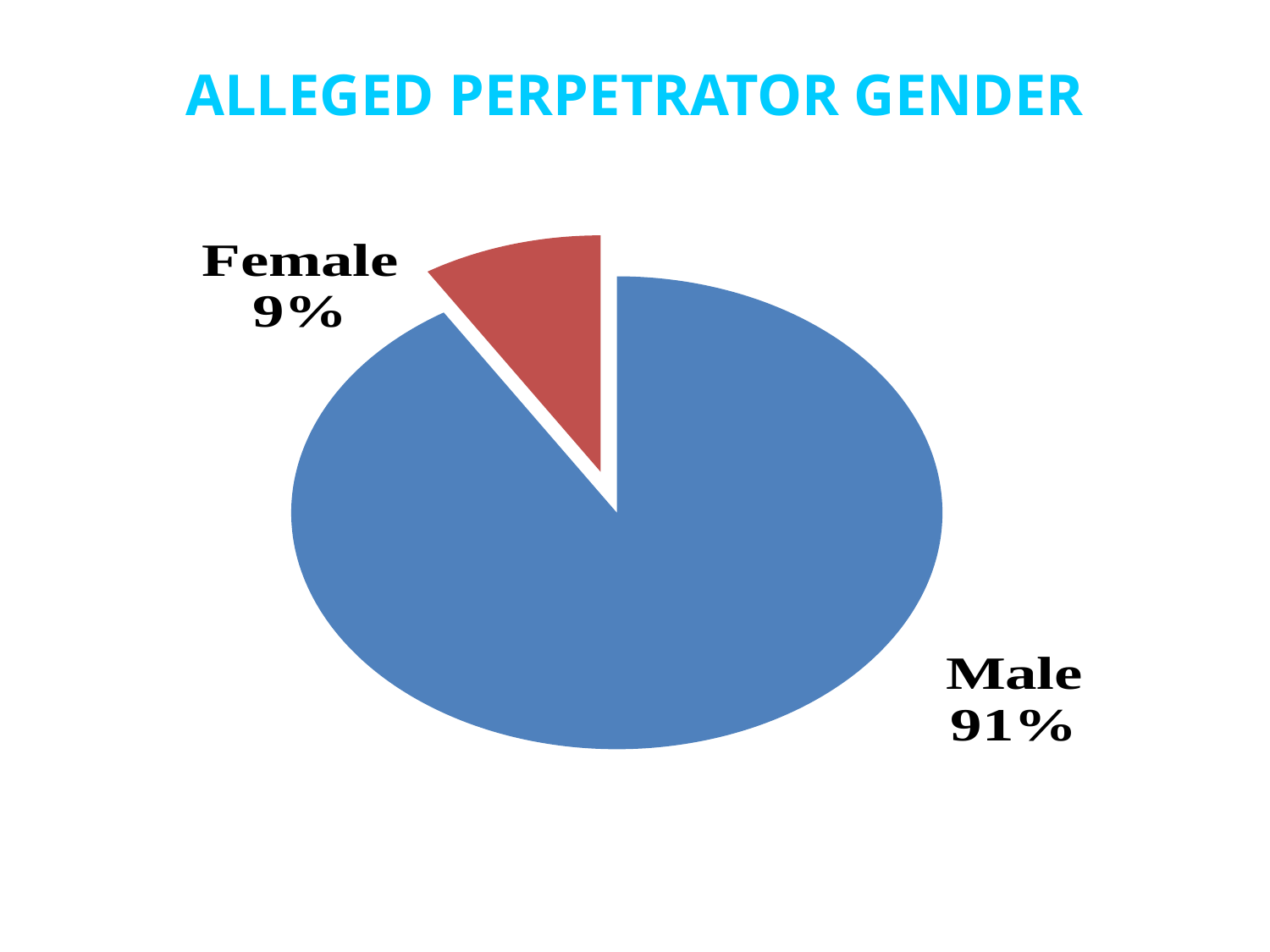
What is the title of the chart? ALLEGED PERPETRATOR GENDER What kind of chart is shown on the slide? Pie chart What colour is the Female slice? Red What percentage of alleged perpetrators are female? 9% What percentage of alleged perpetrators are male? 91% What is the difference in percentage points between the Male and Female shares? 82 What share of the pie does the Female slice represent? 9% Which gender has the largest share of the pie? Male How many slices does the pie chart have? 2 Which share is larger, Male or Female? Male Which gender has the smallest share of the pie? Female